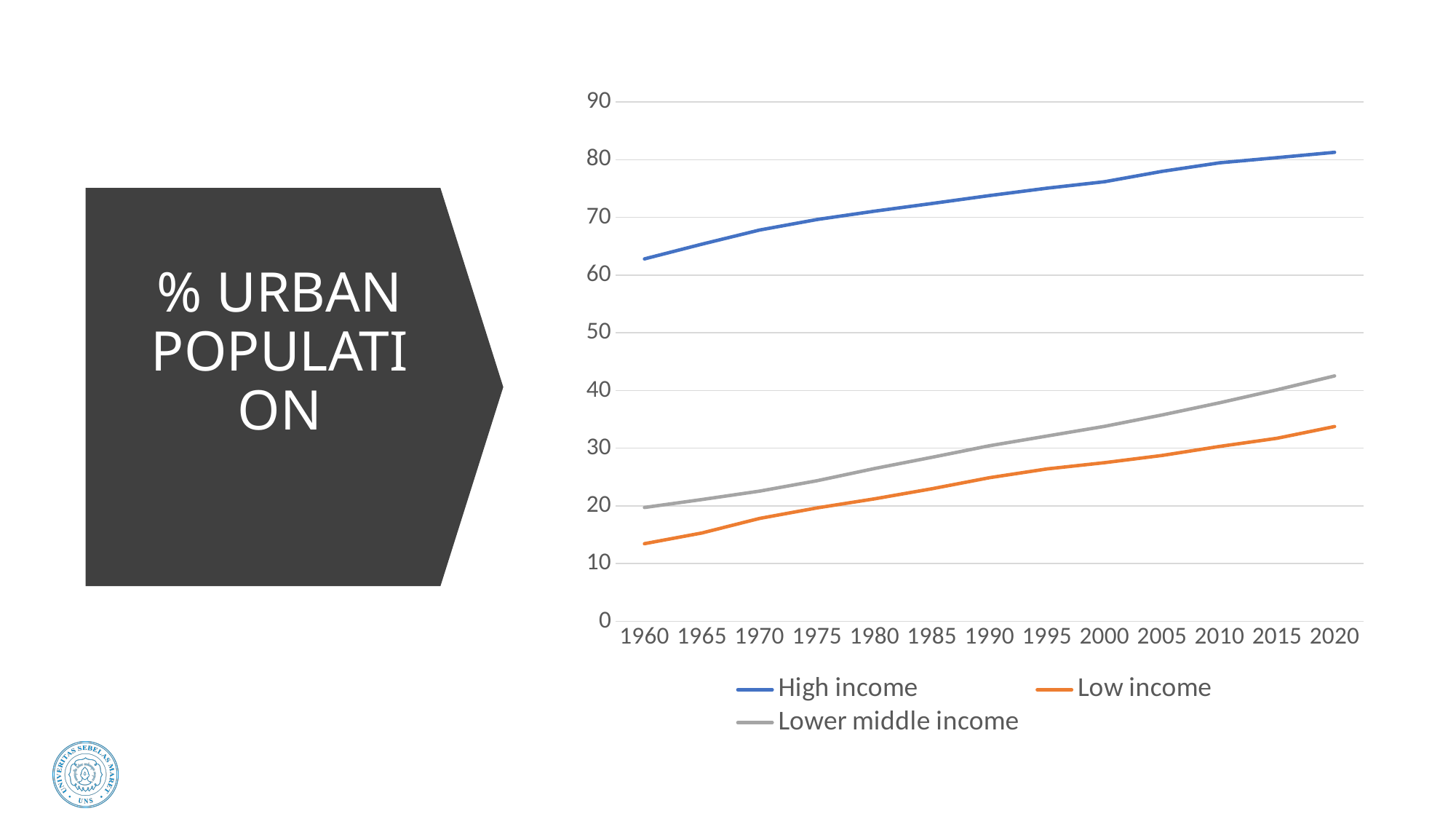
How many years are marked along the x axis? 13 Does the High income line rise or fall from 1960 to 2020? rise Does the Low income line rise or fall from 1960 to 2020? rise Is the value for Low income in 1960 greater or less than 20? less Is the value for Low income in 2020 greater or less than 30? greater Which colour is used for the Lower middle income line? grey Is the value for Lower middle income in 2020 greater or less than 40? greater How many series does the legend list? 3 What kind of chart is shown on the slide? line chart Which series has the lowest value in 1960? Low income Which series has the highest value in 2020? High income